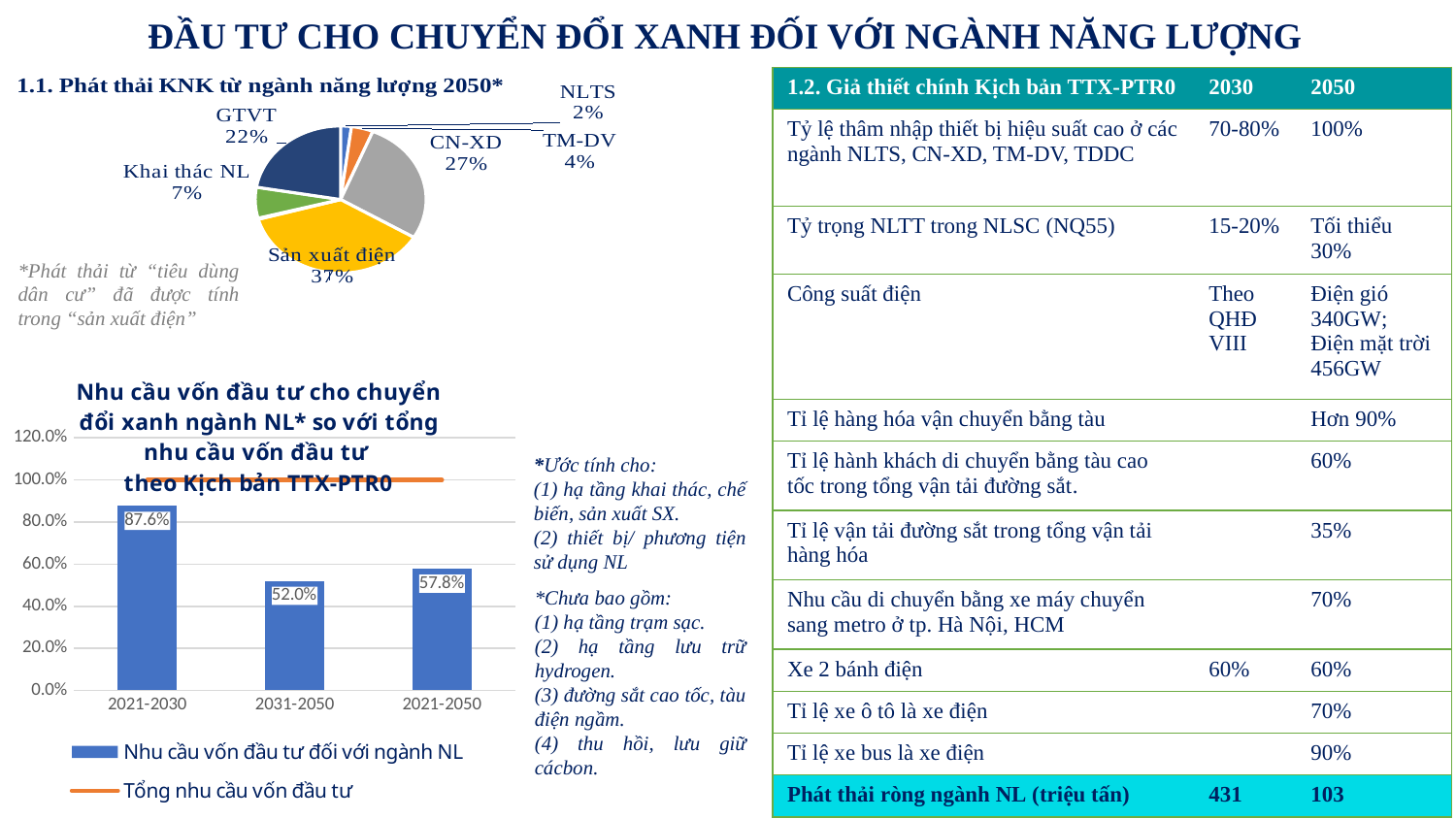
In the bar chart 'Nhu cầu vốn đầu tư cho chuyển đổi xanh ngành NL* so với tổng nhu cầu vốn đầu tư theo Kịch bản TTX-PTR0', which period has the lowest value? 2031-2050 In the bar chart 'Nhu cầu vốn đầu tư cho chuyển đổi xanh ngành NL* so với tổng nhu cầu vốn đầu tư theo Kịch bản TTX-PTR0', what is the value for 2021-2030? 87.6% How many series does the legend of the bar chart 'Nhu cầu vốn đầu tư cho chuyển đổi xanh ngành NL* so với tổng nhu cầu vốn đầu tư theo Kịch bản TTX-PTR0' list? 2 In the pie chart '1.1. Phát thải KNK từ ngành năng lượng 2050*', what is the difference between the shares of GTVT and Khai thác NL? 15% In the pie chart '1.1. Phát thải KNK từ ngành năng lượng 2050*', what share does 'CN-XD' have? 27% In the bar chart 'Nhu cầu vốn đầu tư cho chuyển đổi xanh ngành NL* so với tổng nhu cầu vốn đầu tư theo Kịch bản TTX-PTR0', what is the value for 2031-2050? 52.0% In the pie chart '1.1. Phát thải KNK từ ngành năng lượng 2050*', what share does 'Sản xuất điện' have? 37% In the bar chart 'Nhu cầu vốn đầu tư cho chuyển đổi xanh ngành NL* so với tổng nhu cầu vốn đầu tư theo Kịch bản TTX-PTR0', what is the difference between the values for 2021-2030 and 2021-2050? 29.8% In the pie chart '1.1. Phát thải KNK từ ngành năng lượng 2050*', which category has the largest share? Sản xuất điện In the pie chart '1.1. Phát thải KNK từ ngành năng lượng 2050*', which is larger: GTVT or TM-DV? GTVT